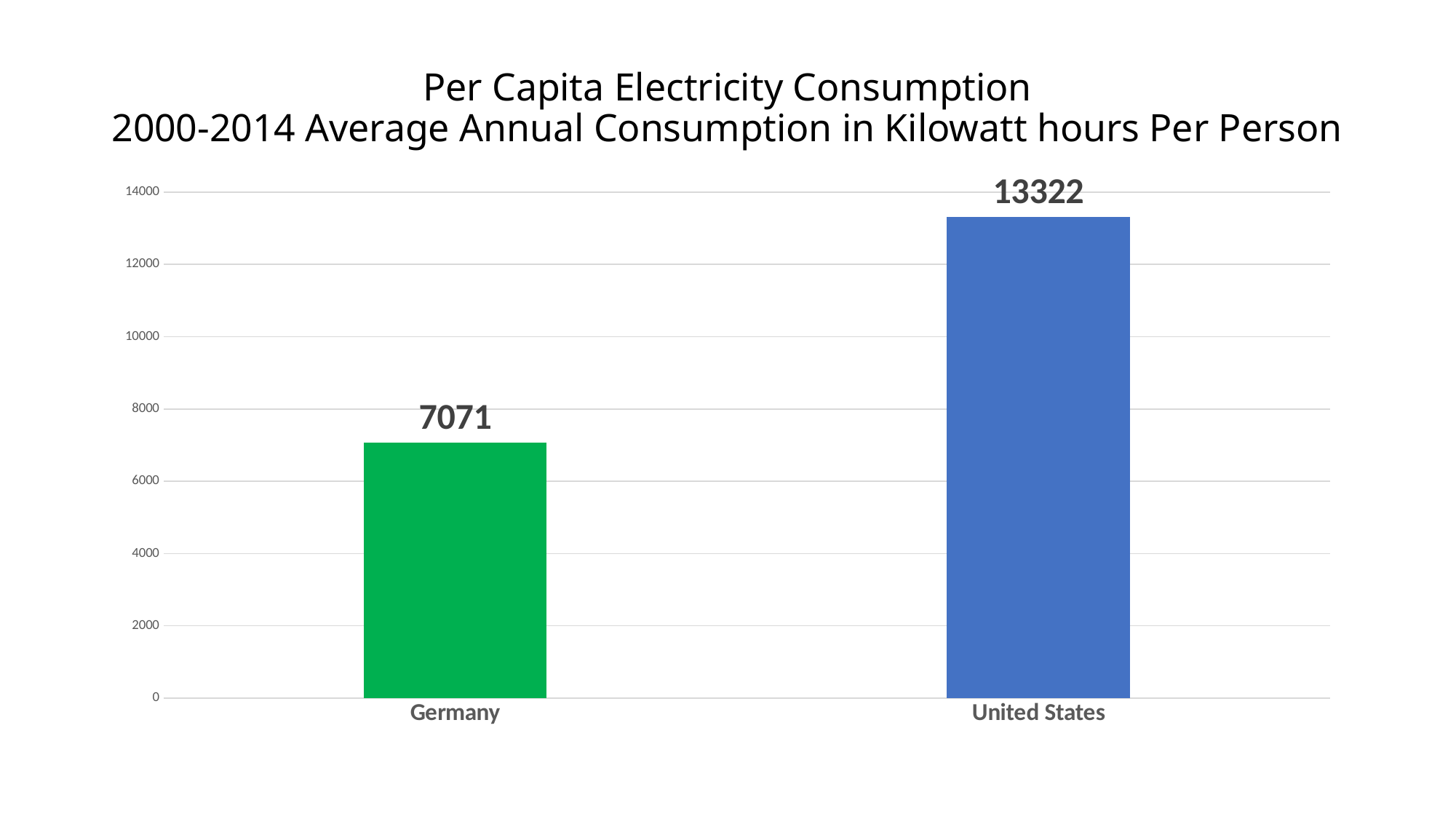
Which country has the lower per capita electricity consumption? Germany Is the value for Germany greater or less than 8000? less Which country has the higher per capita electricity consumption? United States What is the per capita electricity consumption value shown for Germany? 7071 What colour is the bar for Germany? green Is the value for Germany larger or smaller than the value for the United States? smaller What kind of chart is shown on the slide? bar chart How many countries are shown in the chart? 2 What is the per capita electricity consumption value shown for the United States? 13322 What is the title of the chart? Per Capita Electricity Consumption 2000-2014 Average Annual Consumption in Kilowatt hours Per Person Is the value for the United States greater or less than 12000? greater What is the difference between the United States and Germany values? 6251